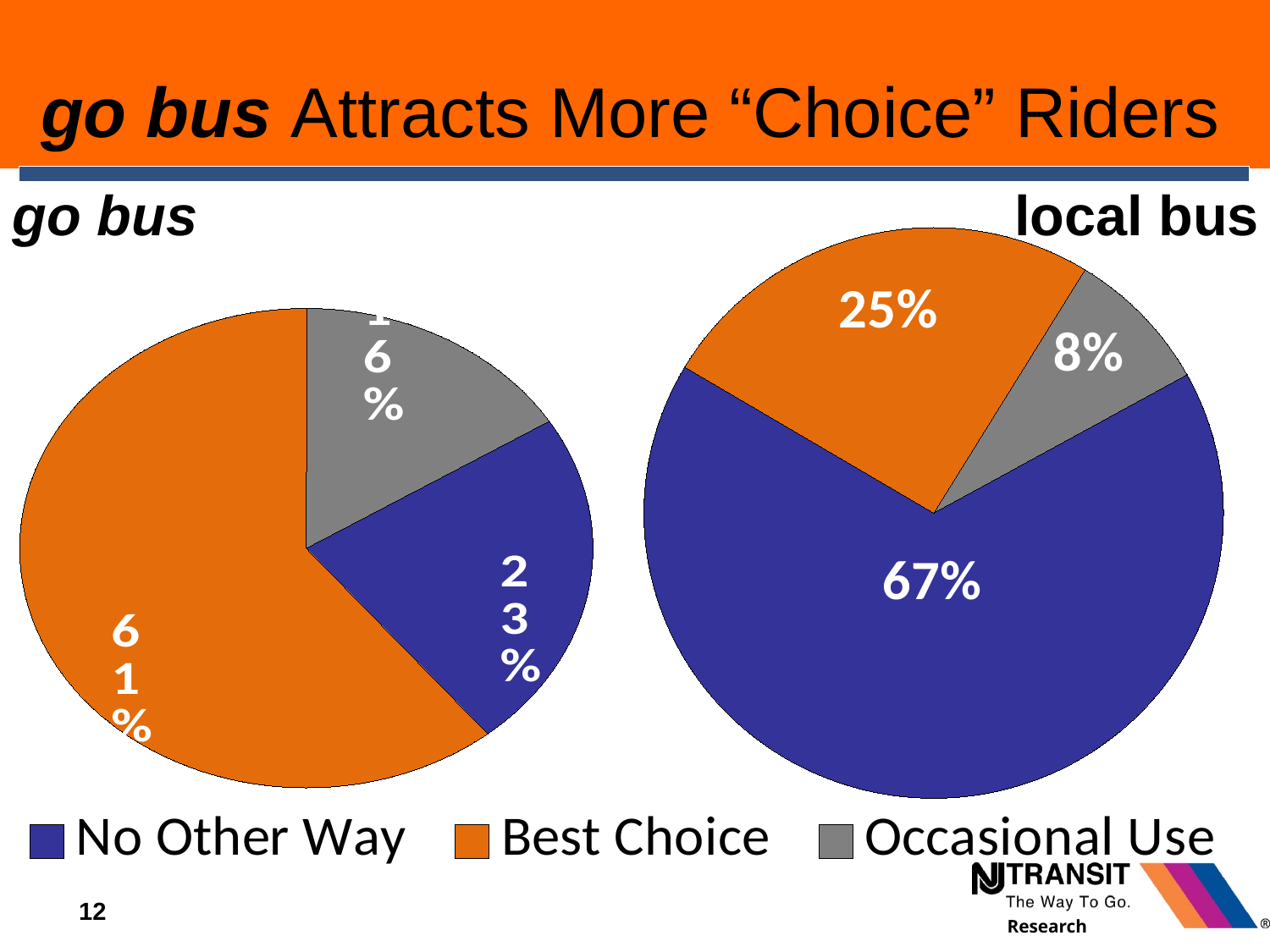
In the local bus pie chart, which category has the smallest slice? Occasional Use In the local bus pie chart, which category has the largest slice? No Other Way In the local bus pie chart, what percentage is shown for Occasional Use? 8% In the go bus pie chart, what percentage is shown for No Other Way? 23% How many categories does the legend list? 3 In the local bus pie chart, what percentage is shown for Best Choice? 25% In the go bus pie chart, what percentage is shown for Best Choice? 61% In the local bus pie chart, how many percentage points larger is No Other Way than Best Choice? 42 percentage points In the local bus pie chart, what percentage is shown for No Other Way? 67% In the go bus pie chart, which category has the largest slice? Best Choice Which chart shows a larger share for Best Choice, go bus or local bus? go bus What kind of charts are shown on the slide? Pie charts